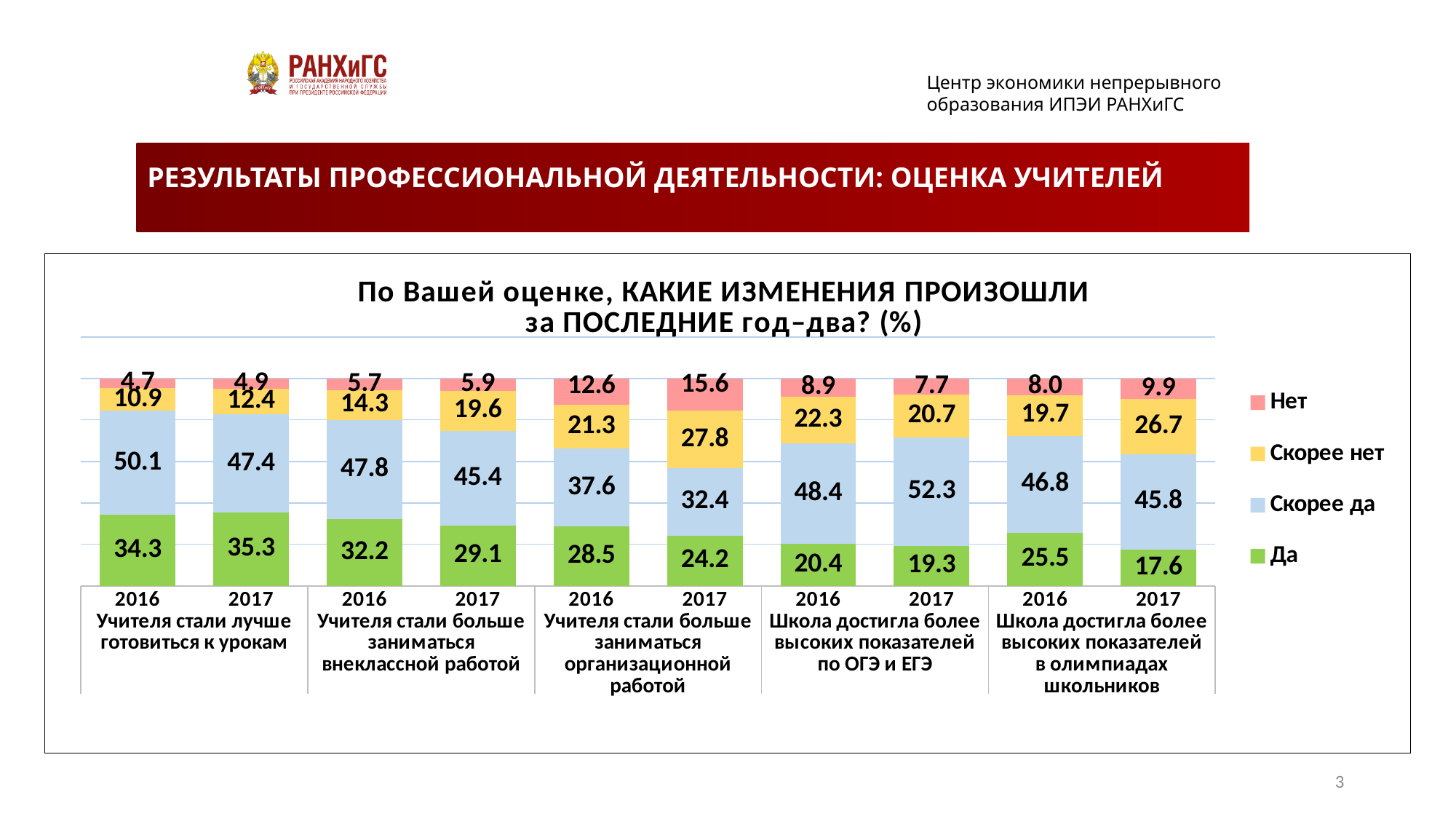
By how much did the "Нет" value change from 2016 to 2017 in the group "Учителя стали больше заниматься организационной работой"? 3.0 What is the value of the "Да" segment for 2017 in the group "Школа достигла более высоких показателей в олимпиадах школьников"? 17.6 How many series does the legend list? 4 What type of chart is shown on the slide? Stacked bar chart Which bar has the highest "Скорее да" value? 2017, Школа достигла более высоких показателей по ОГЭ и ЕГЭ (52.3) What is the value of the "Нет" segment for 2017 in the group "Учителя стали больше заниматься организационной работой"? 15.6 Does the "Да" value rise or fall from 2016 to 2017 in the group "Учителя стали больше заниматься организационной работой"? Fall In the group "Учителя стали больше заниматься внеклассной работой", which year has the larger "Скорее нет" value, 2016 or 2017? 2017 How many stacked bars are shown in the chart? 10 Which bar has the lowest "Да" value? 2017, Школа достигла более высоких показателей в олимпиадах школьников (17.6) What is the total of the 2016 bar in the group "Школа достигла более высоких показателей по ОГЭ и ЕГЭ"? 100.0 What is the value of the "Скорее да" segment for 2016 in the group "Учителя стали лучше готовиться к урокам"? 50.1